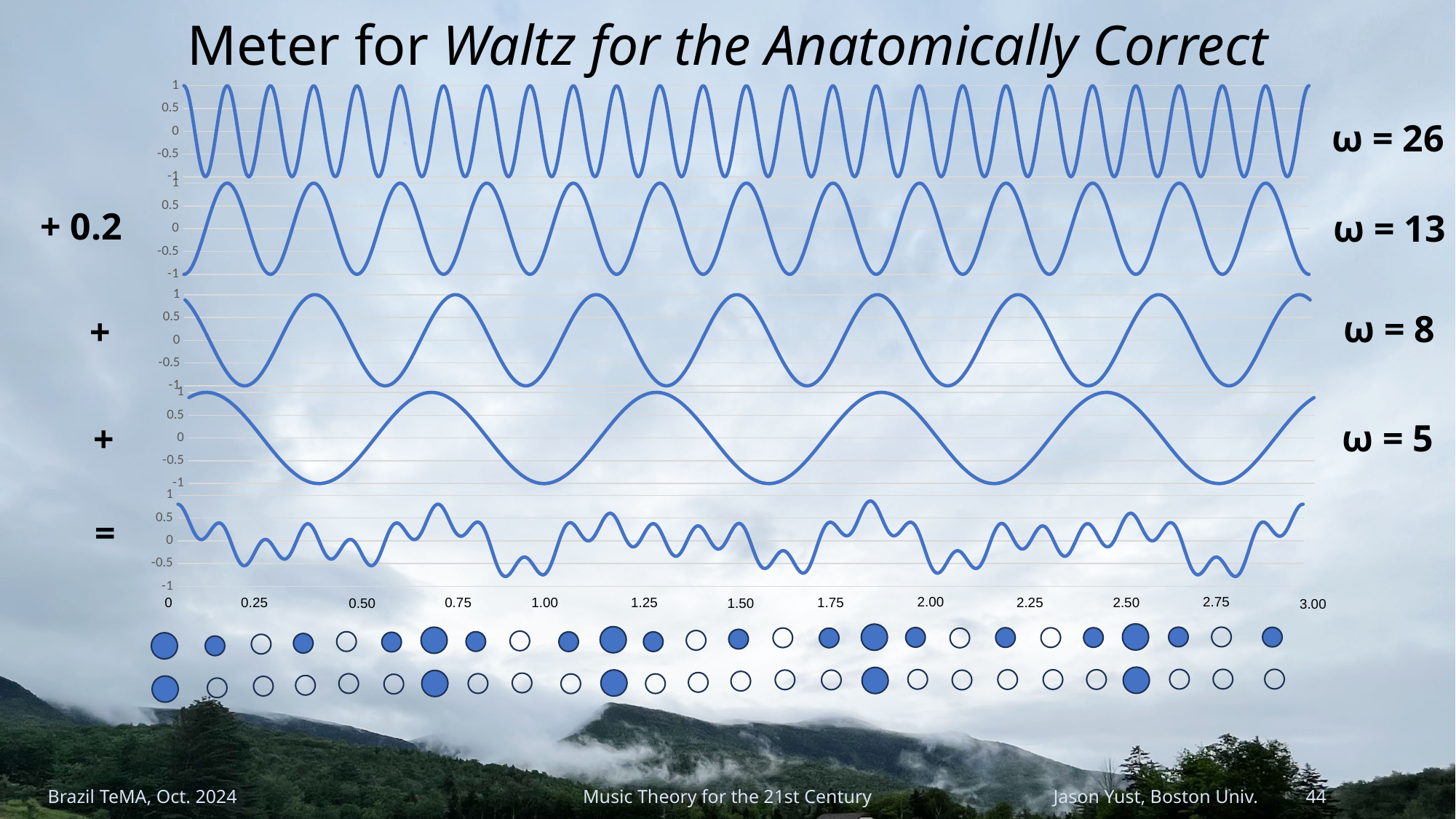
In the ω = 5 chart, what value does the curve take at x = 0? 1 Among the four sinusoid charts, which one has the fewest oscillations? the fourth chart (ω = 5) Which chart shows the most oscillations across the x axis? the top chart (ω = 26) How many separate line charts are stacked on the slide? 5 What is the largest value labelled on the x axis of the bottom chart? 3.00 What are the minimum and maximum values labelled on the y axis of the top chart? -1 and 1 What ω value is labelled next to the top chart? ω = 26 What kind of chart is used for each of the stacked plots on this slide? line chart In the ω = 5 chart, does the curve rise or fall between x = 0 and x = 0.25? fall How many tick labels are printed on the x axis of the bottom chart? 13 What coefficient is shown to the left of the second chart (ω = 13)? + 0.2 In the bottom (sum) chart, is the value at x = 0 greater or less than 0.5? greater